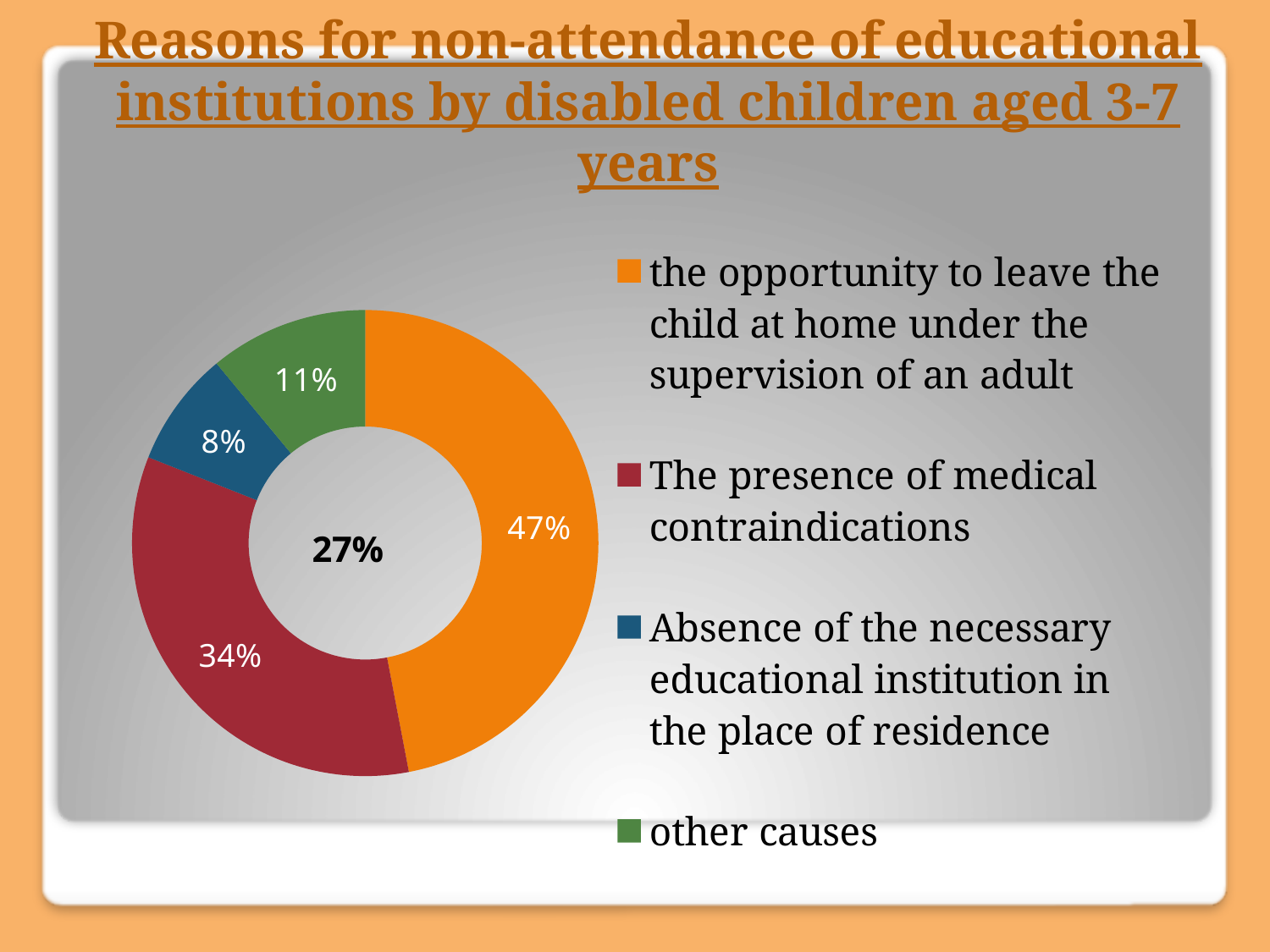
What percentage of the chart is attributed to the opportunity to leave the child at home under the supervision of an adult? 47% What percentage is shown for absence of the necessary educational institution in the place of residence? 8% What share does the presence of medical contraindications account for? 34% What percentage is shown for other causes? 11% What is the title of the slide containing the chart? Reasons for non-attendance of educational institutions by disabled children aged 3-7 years How many percentage points larger is the share for the opportunity to leave the child at home than the share for the presence of medical contraindications? 13 Which reason has the largest share of the chart? the opportunity to leave the child at home under the supervision of an adult What colour represents the presence of medical contraindications in the chart? red Which is larger: the share for other causes or the share for absence of the necessary educational institution in the place of residence? other causes What kind of chart is shown on the slide? doughnut (pie) chart How many categories does the chart show? 4 Which reason has the smallest share of the chart? Absence of the necessary educational institution in the place of residence